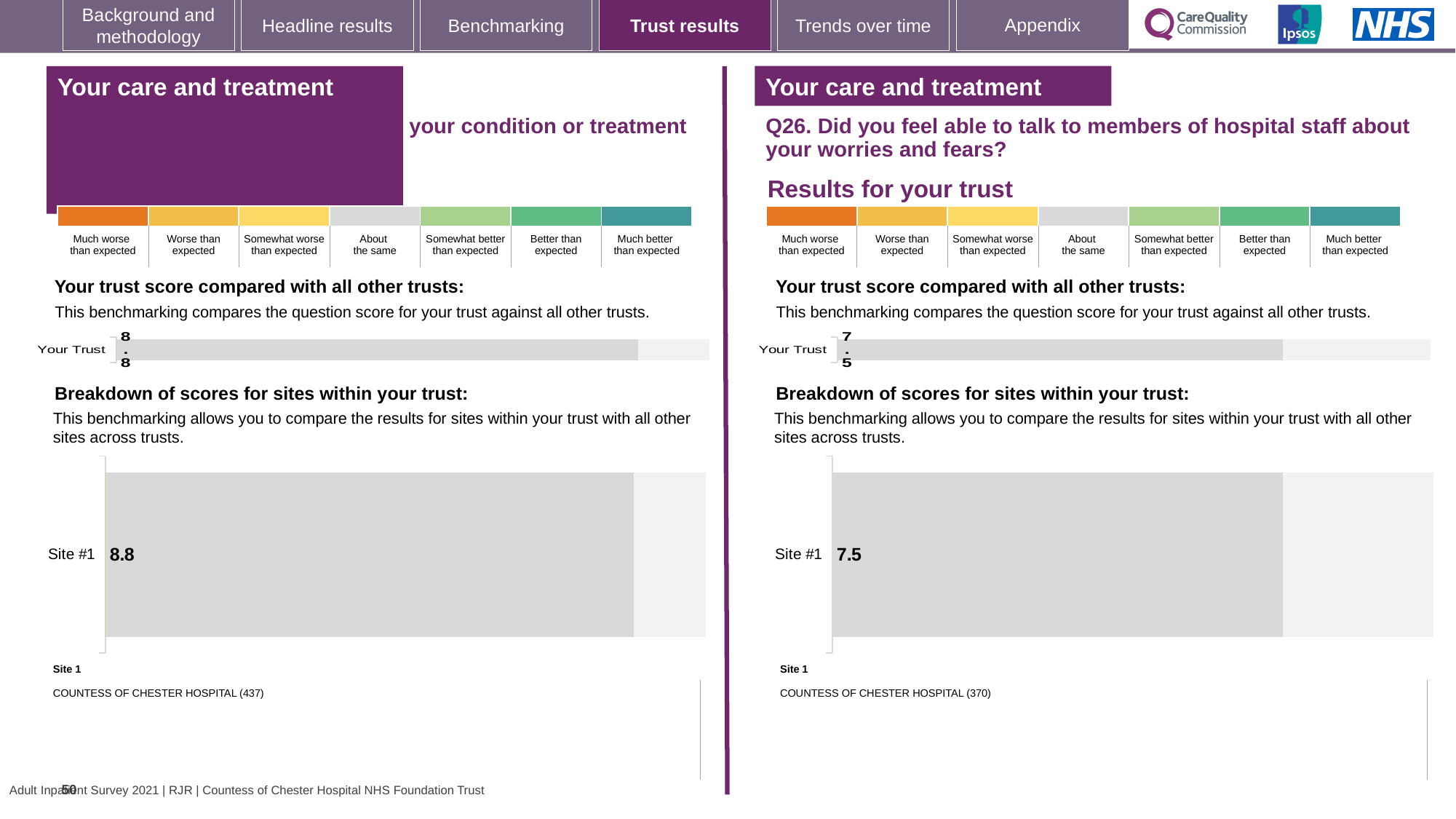
How many bars are plotted in the 'Your trust score compared with all other trusts' chart on the right panel (Q26)? 1 How many sites are shown in the 'Breakdown of scores for sites within your trust' chart on the left panel? 1 On the right panel (Q26), which site name is listed under Site 1 below the breakdown chart? COUNTESS OF CHESTER HOSPITAL (370) On the left panel, what is the label of the category in the 'Breakdown of scores for sites within your trust' chart? Site #1 On the right panel (Q26), in the 'Your trust score compared with all other trusts' chart, what is the value for Your Trust? 7.5 On the left panel, in the 'Your trust score compared with all other trusts' chart, what is the value for Your Trust? 8.8 Comparing the Site #1 bars, is the value on the left panel or the right panel (Q26) larger? Left panel On the right panel (Q26), in the 'Breakdown of scores for sites within your trust' chart, what is the value for Site #1? 7.5 On the left panel, in the 'Breakdown of scores for sites within your trust' chart, what is the value for Site #1? 8.8 What kind of chart is used to show the Site #1 score on the right panel (Q26)? Bar chart What is the difference between the Your Trust value on the left panel and the Your Trust value on the right panel (Q26)? 1.3